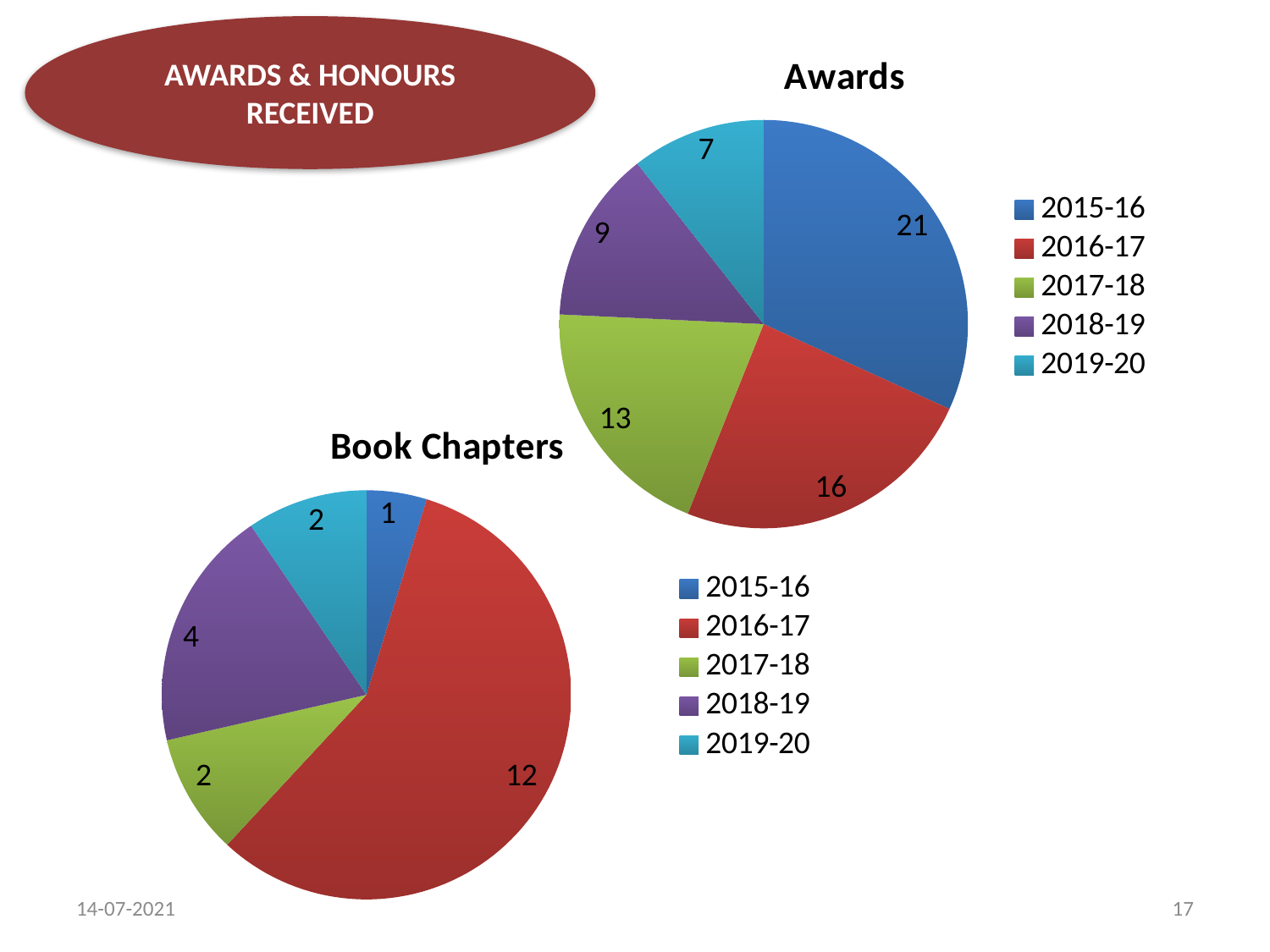
What kind of chart is the Awards chart? Pie chart In the Awards chart, which year has the smallest slice? 2019-20 In the Awards chart, what is the value for 2015-16? 21 In the Awards chart, which year has the largest slice? 2015-16 In the Book Chapters chart, what is the value for 2018-19? 4 In the Awards chart, what is the value for 2018-19? 9 In the Book Chapters chart, what is the difference between the values for 2016-17 and 2018-19? 8 In the Awards chart, which is larger, the value for 2017-18 or the value for 2019-20? 2017-18 In the Book Chapters chart, which year has the smallest slice? 2015-16 In the Book Chapters chart, what is the value for 2016-17? 12 In the Awards chart, what is the difference between the values for 2015-16 and 2016-17? 5 How many categories does the Book Chapters chart show? 5